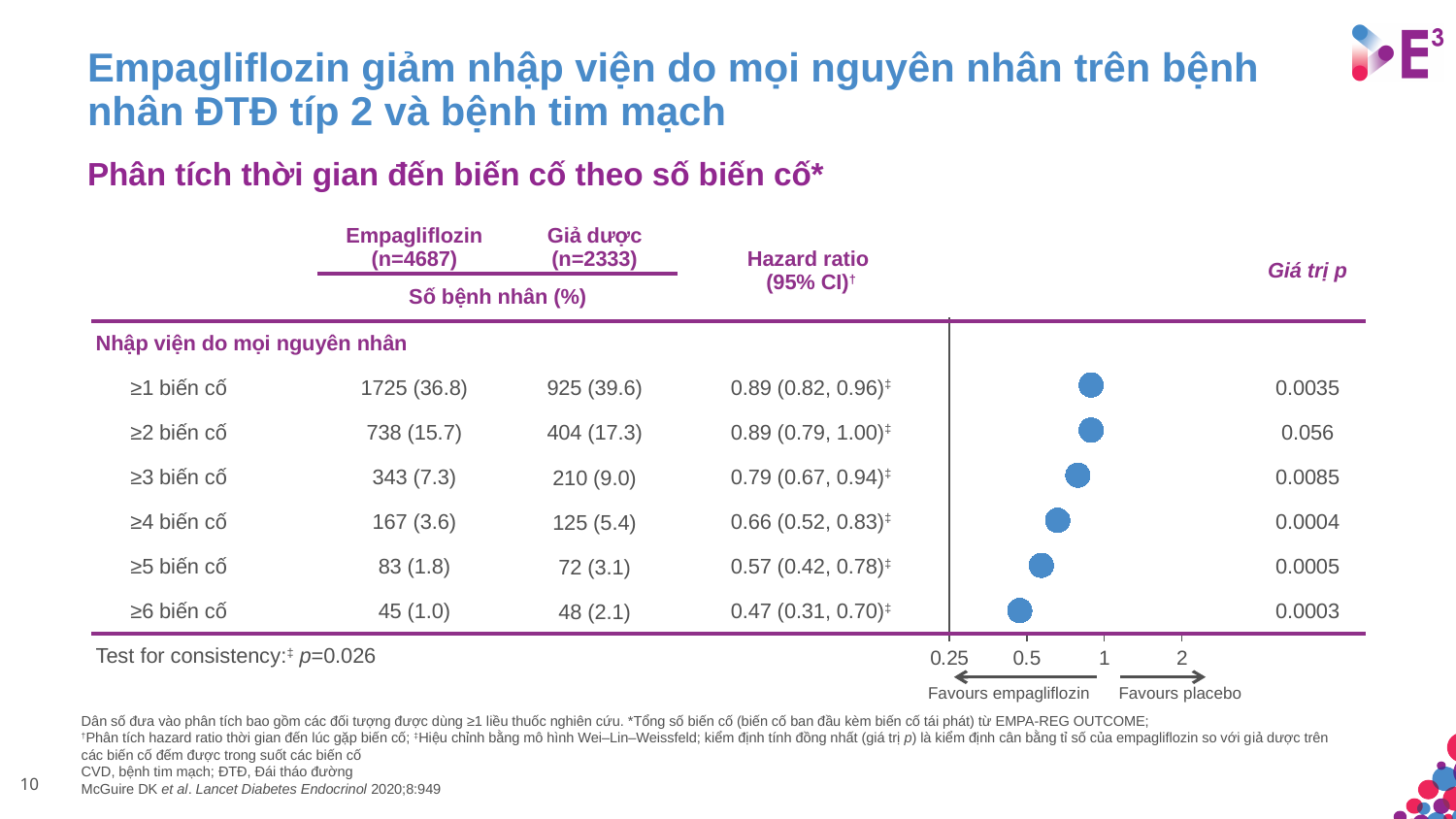
What is the p-value shown for ≥4 biến cố? 0.0004 What label appears under the left arrow of the hazard ratio axis? Favours empagliflozin What is the hazard ratio plotted for ≥6 biến cố? 0.47 How many hazard ratio points are plotted on the forest plot? 6 Is the hazard ratio for ≥6 biến cố greater or less than 0.5? less Is the hazard ratio for ≥3 biến cố greater or less than 1? less Which category has the lowest hazard ratio on the forest plot? ≥6 biến cố Do the plotted hazard ratios rise or fall as the number of events increases from ≥1 to ≥6 biến cố? fall What is the hazard ratio plotted for ≥4 biến cố? 0.66 What is the difference between the hazard ratios for ≥3 biến cố and ≥6 biến cố? 0.32 Which has the larger hazard ratio, ≥2 biến cố or ≥5 biến cố? ≥2 biến cố What is the hazard ratio plotted for ≥1 biến cố? 0.89